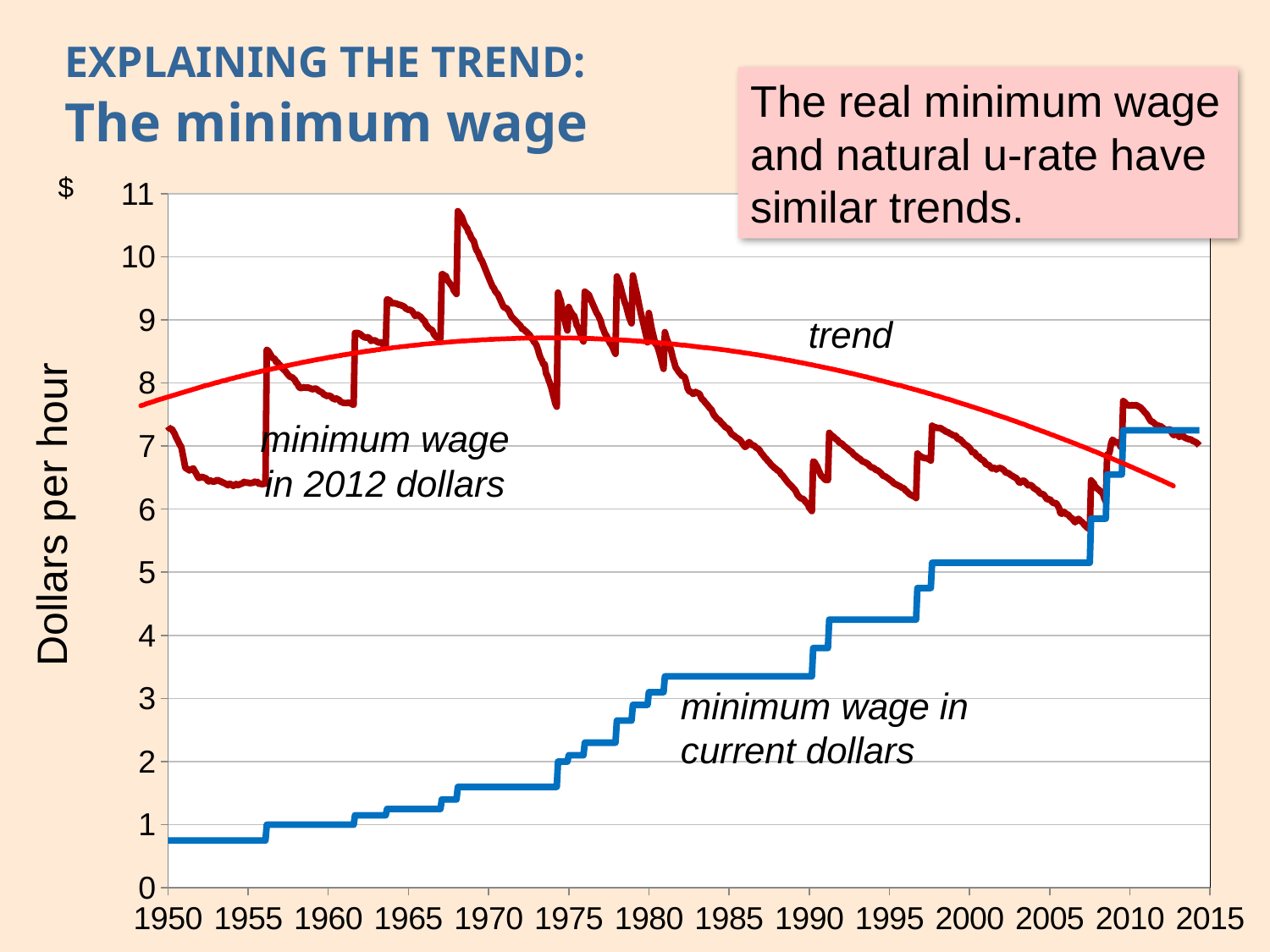
What kind of chart is shown on the slide? line chart Is the peak of the minimum wage in 2012 dollars around 1968 greater or less than 10? greater Does the trend line for the minimum wage in 2012 dollars rise or fall between 1990 and 2015? fall Does the minimum wage in current dollars rise or fall from 1950 to 2015? rise Is the minimum wage in current dollars in 2000 greater or less than 6? less How many lines are plotted on the chart? 3 Is the minimum wage in current dollars in 2010 greater or less than 7? greater What is the label on the vertical axis of the chart? Dollars per hour In 1970, which is higher: the minimum wage in 2012 dollars or the minimum wage in current dollars? minimum wage in 2012 dollars Which line is labelled 'trend' on the chart? the smooth red curve